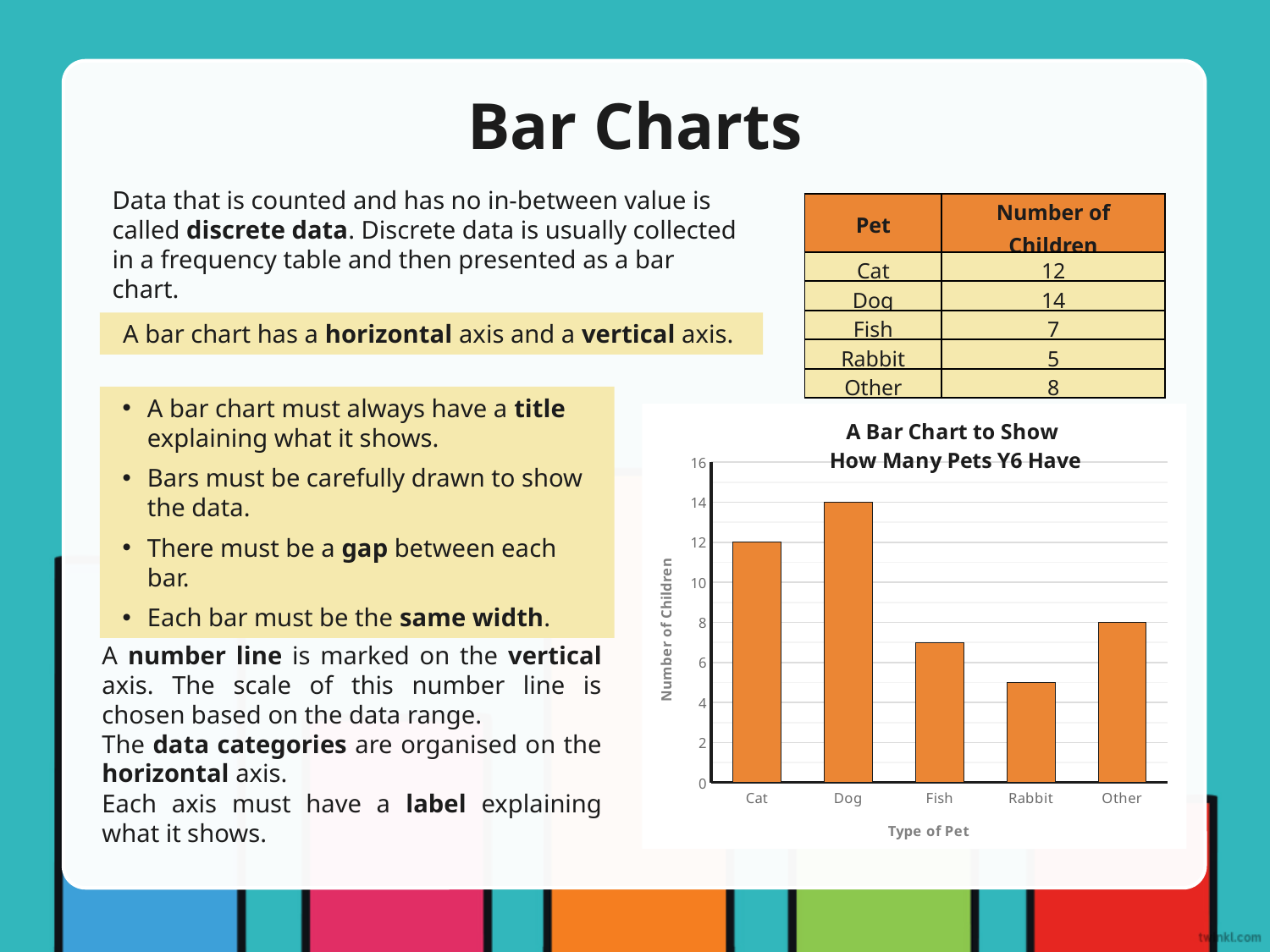
How many more children have a dog than a cat? 2 Which is larger, the value for Fish or the value for Other? Other Which type of pet has the highest bar? Dog What is the difference between the values for Cat and Other? 4 Is the value for Fish greater or less than 8? less How many children have a cat according to the chart? 12 How many children have a dog according to the chart? 14 How many types of pet are shown on the horizontal axis? 5 What type of chart is shown on the slide? Bar chart What is the value for Other on the chart? 8 Which type of pet has the lowest bar? Rabbit What is the title of the chart? A Bar Chart to Show How Many Pets Y6 Have